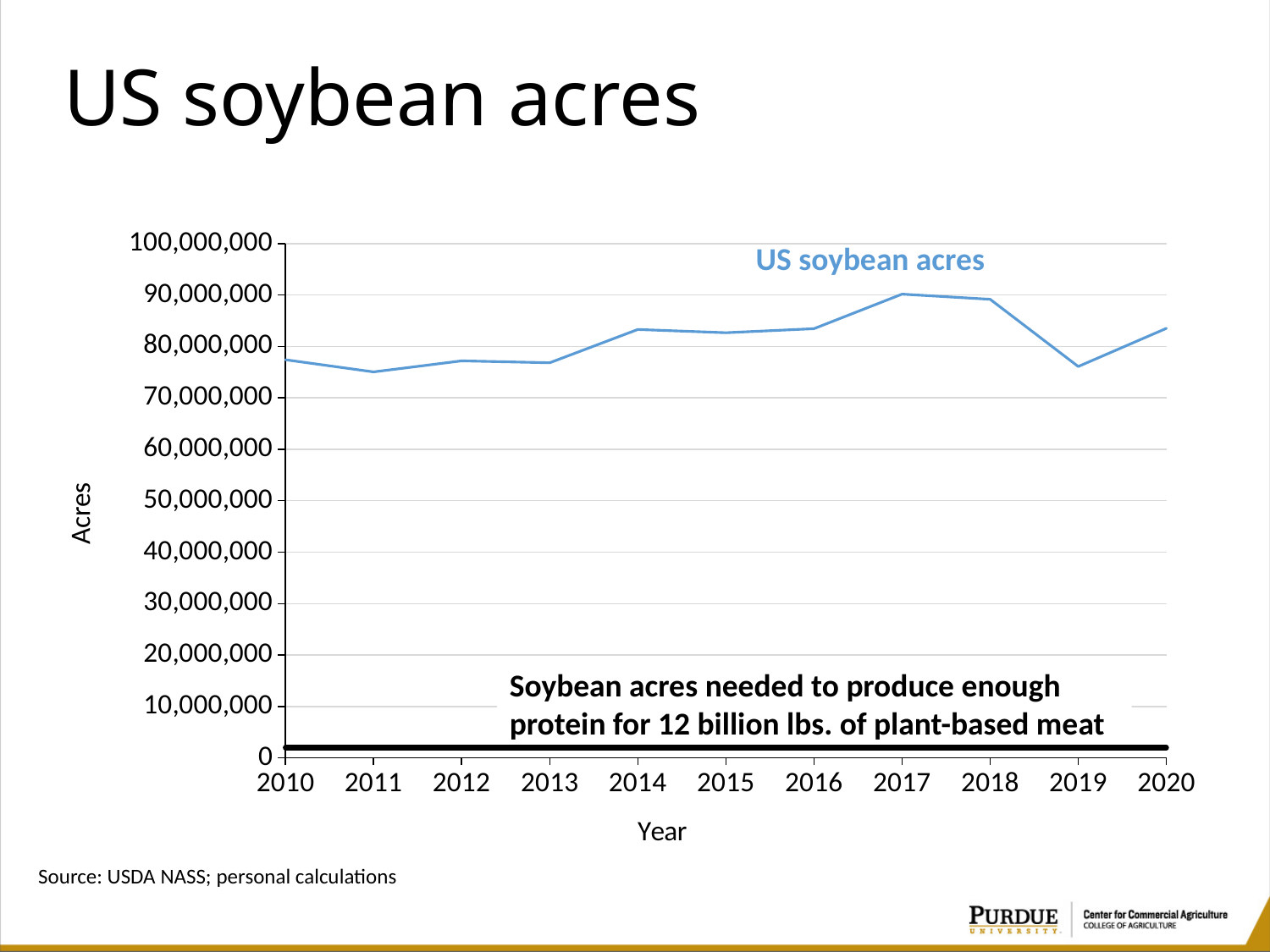
Which year has more US soybean acres, 2017 or 2019? 2017 Is the value of US soybean acres in 2019 greater or less than 80,000,000? less Is the value of US soybean acres in 2017 greater or less than 80,000,000? greater What is the title of the chart? US soybean acres How many years are plotted along the x axis of the chart? 11 How many lines (series) are plotted on the chart? 2 Is the value of US soybean acres in 2011 greater or less than 80,000,000? less In which year does the US soybean acres line reach its highest value? 2017 What kind of chart is shown on the slide? line chart What is the label on the y axis of the chart? Acres Does the US soybean acres line rise or fall between 2017 and 2019? fall